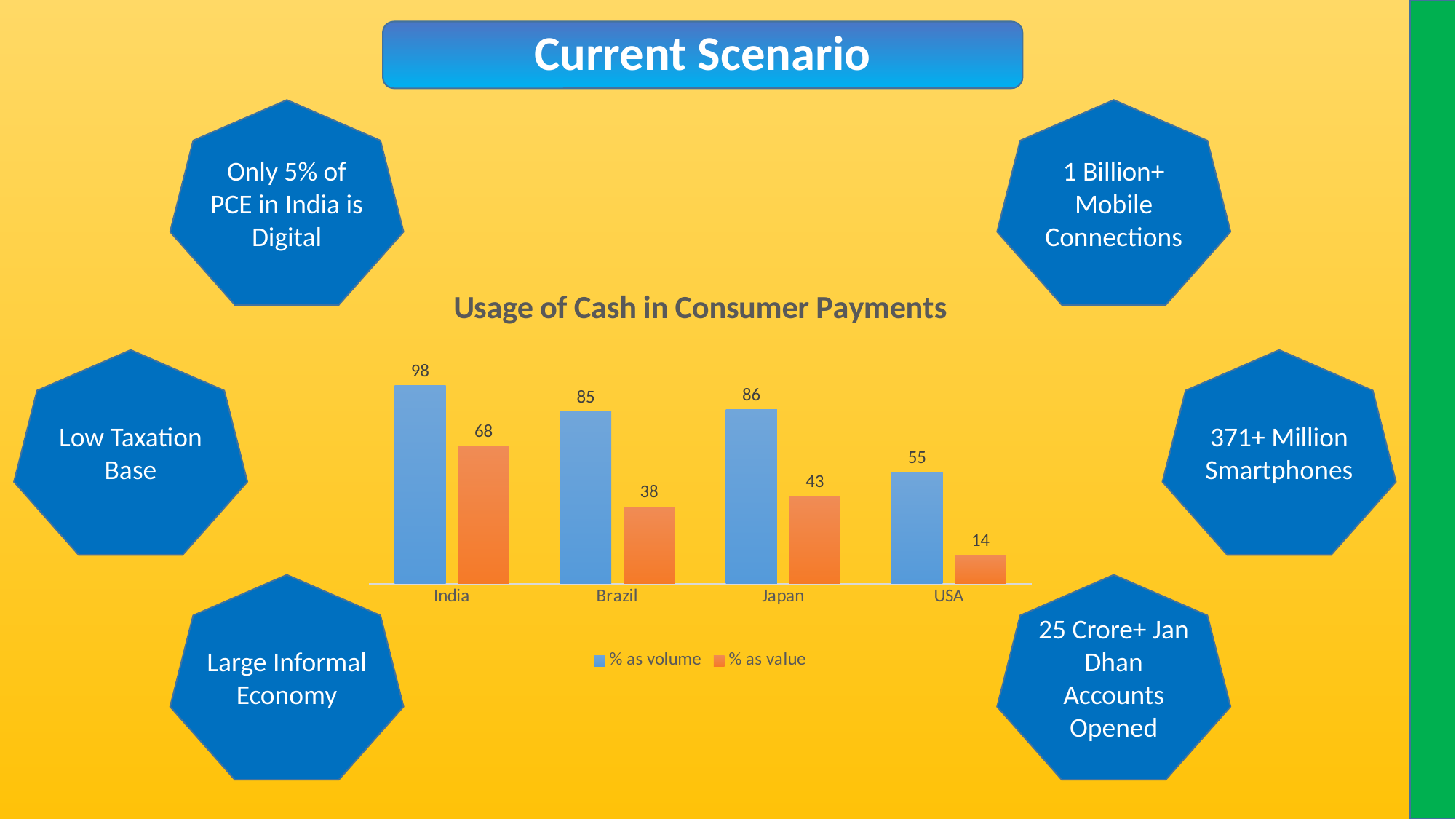
How many countries are shown on the x axis of the chart? 4 What is the '% as value' value for Brazil? 38 What kind of chart is shown on the slide? Bar chart Which country has the lowest '% as value' value? USA What is the '% as volume' value for India? 98 Which is larger: the '% as value' for India or the '% as value' for Japan? India How many series does the chart legend list? 2 Which colour represents the '% as value' series in the chart? Orange What is the '% as value' value for USA? 14 What is the title of the chart? Usage of Cash in Consumer Payments What is the difference between the '% as volume' and '% as value' values for Japan? 43 Which country has the highest '% as volume' value? India